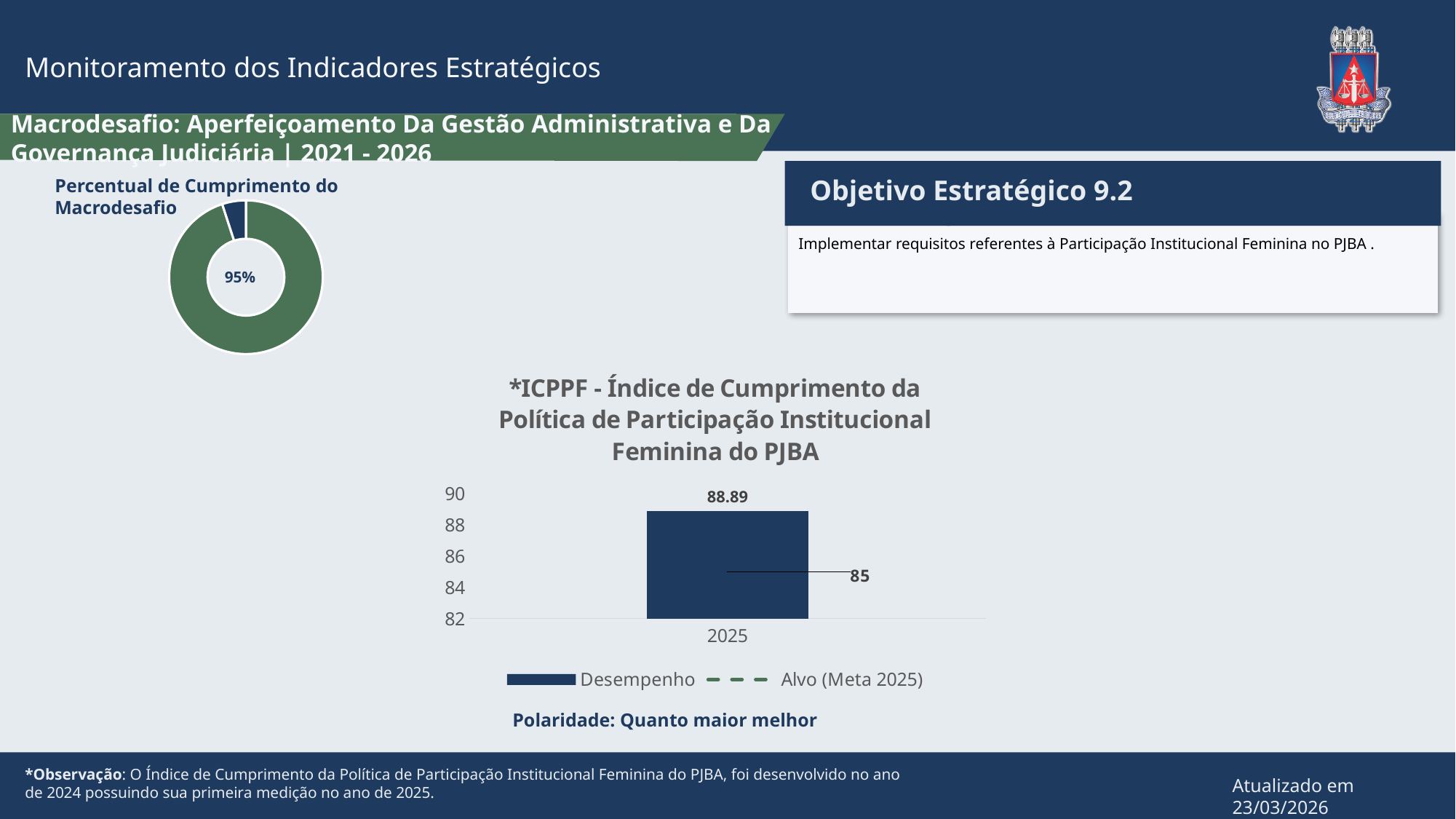
In the ICPPF chart, what is the difference between the Desempenho value and the Alvo (Meta 2025) value? 3.89 In the ICPPF chart, what is the polarity stated below the legend? Quanto maior melhor In the ICPPF chart, is the Desempenho value for 2025 greater or less than 86? greater In the ICPPF chart, what is the Alvo (Meta 2025) value? 85 In the ICPPF chart, what is the Desempenho value for 2025? 88.89 In the ICPPF chart, which year is shown on the x axis? 2025 In the ICPPF chart, which is larger, the Desempenho value for 2025 or the Alvo (Meta 2025)? Desempenho In the ICPPF chart, how many series does the legend list? 2 In the Percentual de Cumprimento do Macrodesafio chart, what percentage is shown in the centre? 95% In the ICPPF chart, how many years are shown on the x axis? 1 What kind of chart is the ICPPF chart? bar chart What kind of chart is the Percentual de Cumprimento do Macrodesafio chart? doughnut chart